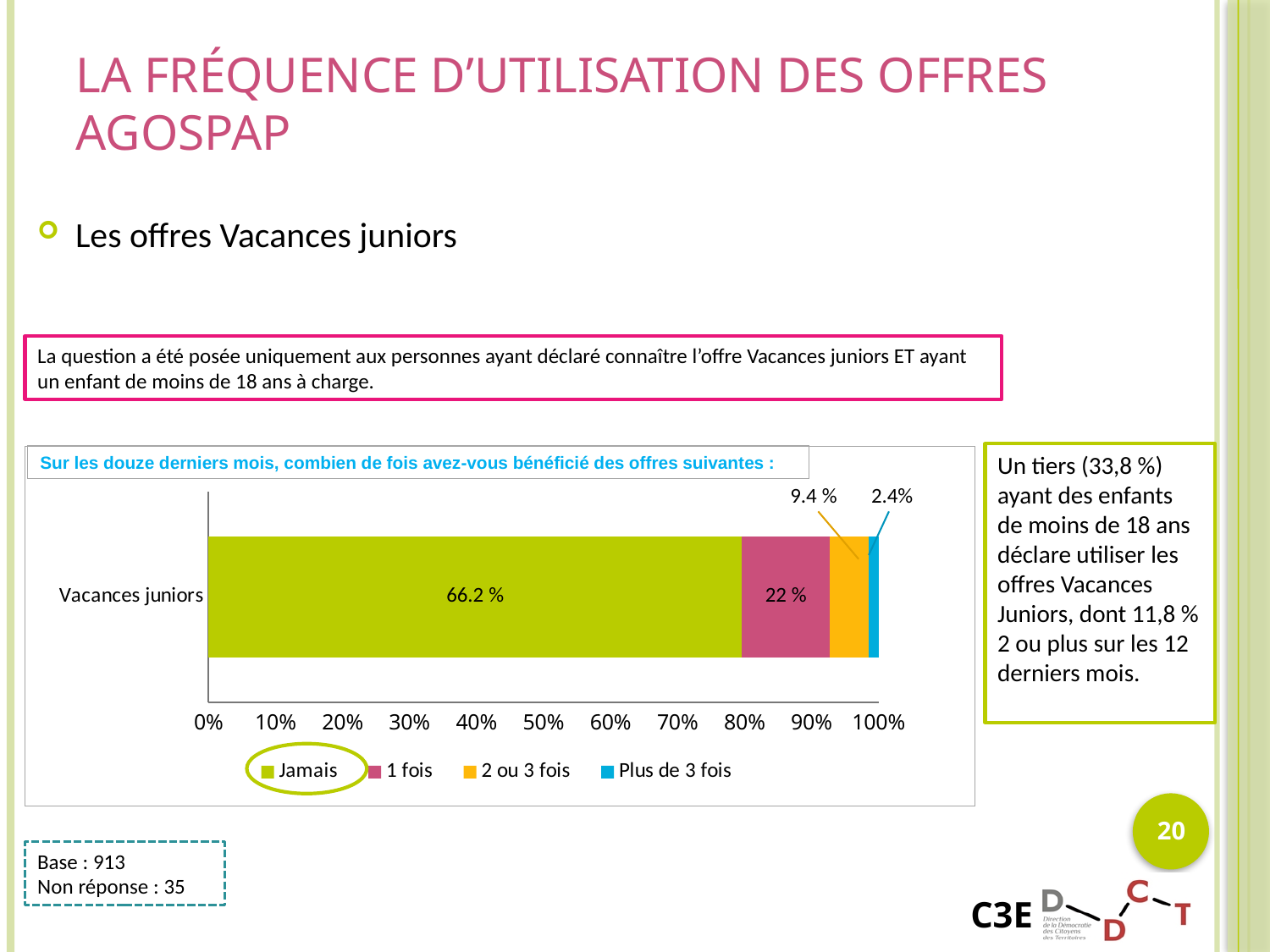
What is the value for "1 fois" in the Vacances juniors bar? 22 % What is the value for "Jamais" in the Vacances juniors bar? 66.2 % What is the value for "2 ou 3 fois" in the Vacances juniors bar? 9.4 % What kind of chart is shown on the slide? Stacked bar chart What is the value for "Plus de 3 fois" in the Vacances juniors bar? 2.4% How many series does the legend list? 4 Which is larger, the value for "1 fois" or the value for "2 ou 3 fois"? 1 fois What is the difference between the "Jamais" value and the "1 fois" value? 44.2 percentage points Is the value for "Jamais" greater or less than 60%? greater Which legend entry is circled on the chart? Jamais Which series has the smallest share of the Vacances juniors bar? Plus de 3 fois Which series has the largest share of the Vacances juniors bar? Jamais